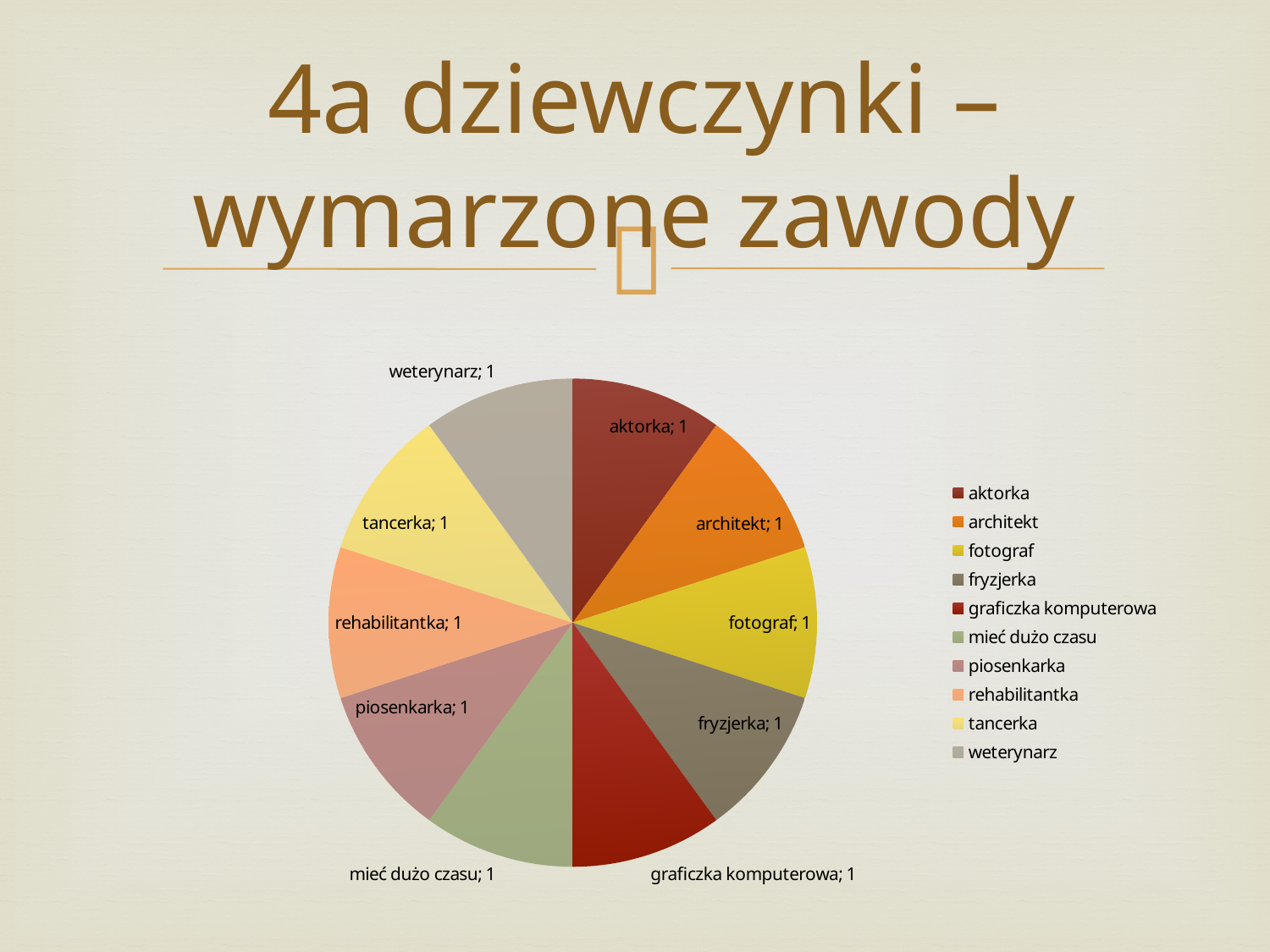
Which legend entry is listed last? weterynarz What kind of chart is shown on the slide? pie chart What is the title of the slide containing the chart? 4a dziewczynki – wymarzone zawody How many entries does the legend list? 10 What is the total of all the slice values in the pie chart? 10 What is the value for fotograf? 1 What is the difference between the values for tancerka and piosenkarka? 0 What is the value for aktorka? 1 How many slices does the pie chart have? 10 What is the value for graficzka komputerowa? 1 What share of the pie does the rehabilitantka slice represent? 10% What is the value for weterynarz? 1